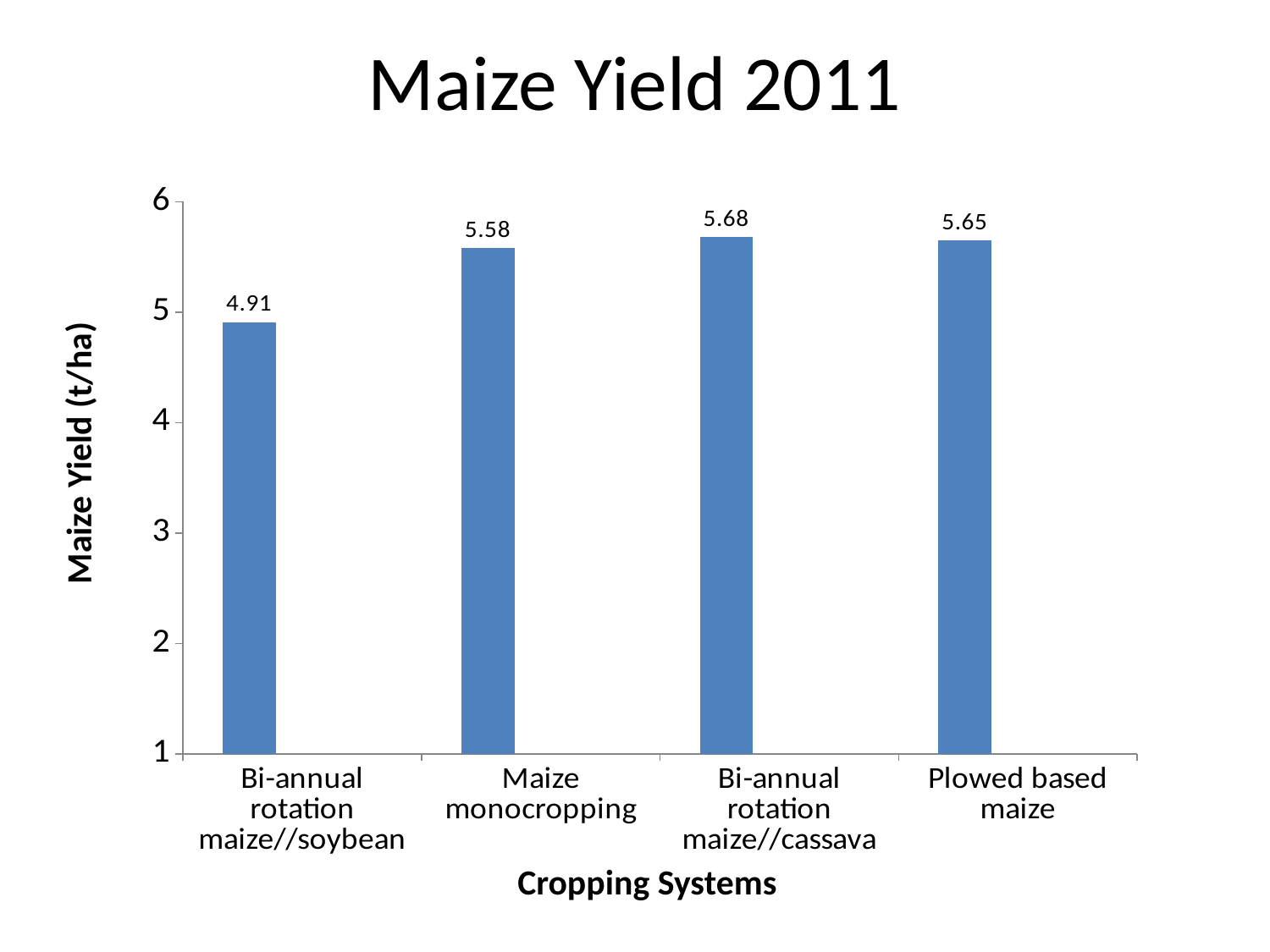
Which cropping system has the lowest maize yield? Bi-annual rotation maize//soybean What type of chart is shown on the slide? Bar chart What is the maize yield for Maize monocropping? 5.58 What is the maize yield for Bi-annual rotation maize//cassava? 5.68 What is the maize yield for Bi-annual rotation maize//soybean? 4.91 How many cropping systems are shown in the chart? 4 What is the difference in maize yield between Plowed based maize and Maize monocropping? 0.07 Which has a higher maize yield, Maize monocropping or Bi-annual rotation maize//soybean? Maize monocropping Which cropping system has the highest maize yield? Bi-annual rotation maize//cassava What is the maize yield for Plowed based maize? 5.65 Is the maize yield for Bi-annual rotation maize//soybean greater or less than 5? less What is the difference in maize yield between Bi-annual rotation maize//cassava and Bi-annual rotation maize//soybean? 0.77